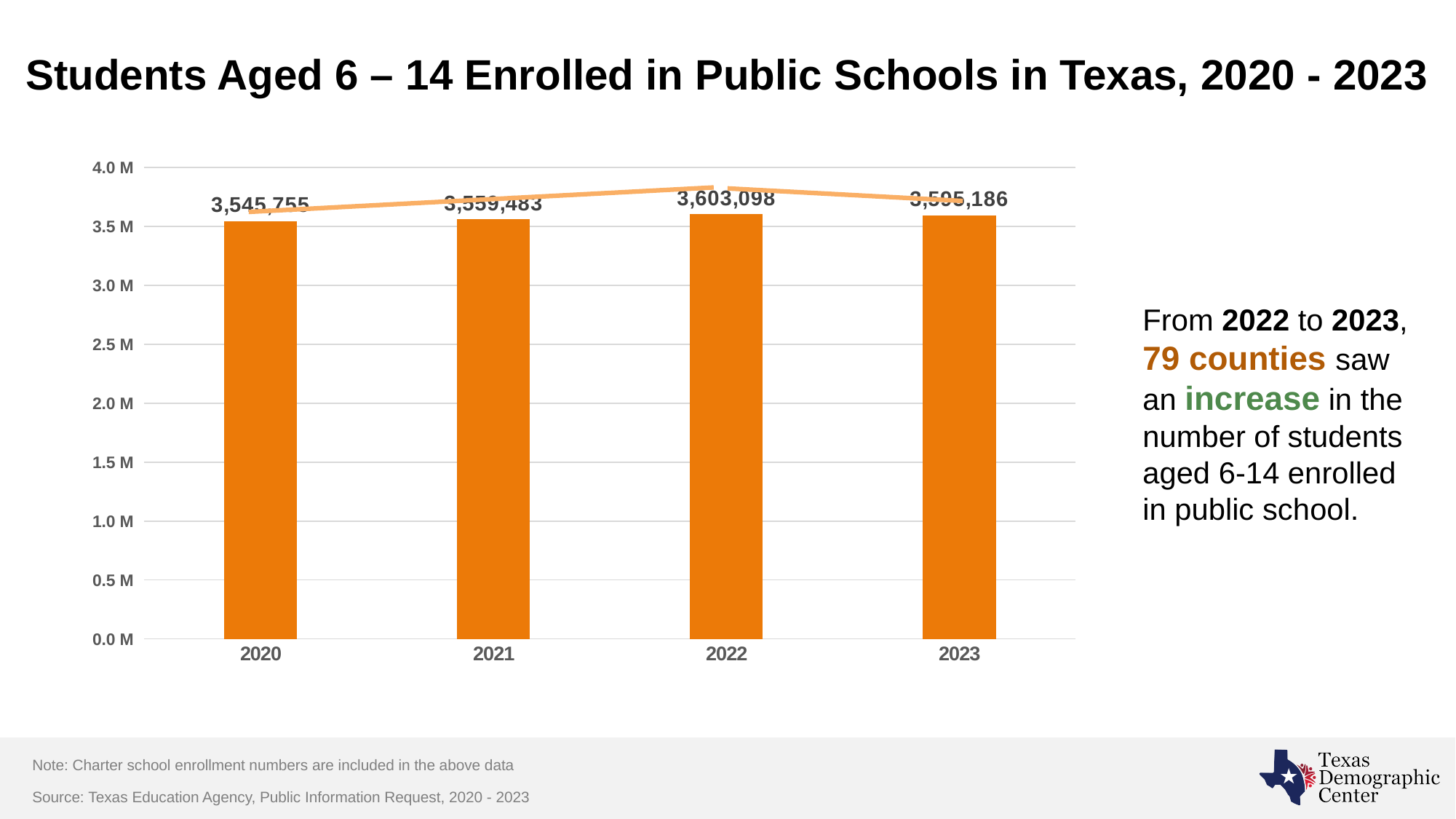
How many years are shown on the x axis of the chart? 4 What kind of chart is used to show the enrollment data? Bar chart What is the difference in enrollment between 2021 and 2020? 13,728 Which year has the lowest enrollment according to the data labels? 2020 What is the number of students aged 6–14 enrolled in Texas public schools in 2020? 3,545,755 By how much did enrollment decrease from 2022 to 2023? 7,912 Which year has the highest enrollment according to the data labels? 2022 What is the enrollment value shown for 2023? 3,595,186 What is the enrollment value shown for 2022? 3,603,098 Is the enrollment value for 2021 greater or less than 3.0 M? greater What is the enrollment value shown for 2021? 3,559,483 Does enrollment rise or fall from 2022 to 2023? Fall